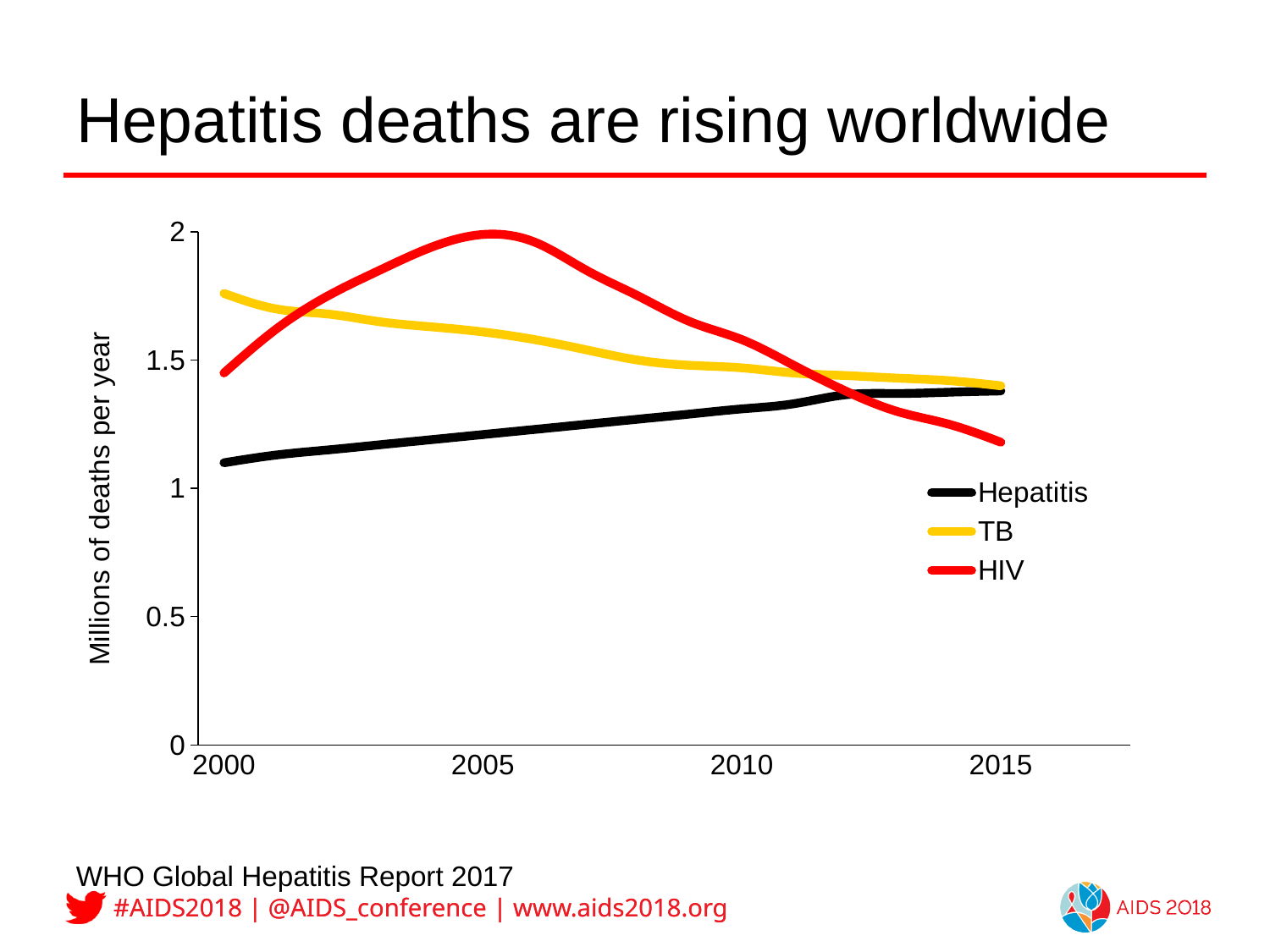
Is the value for Hepatitis in 2000 greater or less than 1.5? less What is the title of the chart on the slide? Hepatitis deaths are rising worldwide How many series does the legend list? 3 Which series are listed in the legend? Hepatitis, TB, HIV What kind of chart is shown on the slide? line chart Which series has the lowest value in 2000? Hepatitis Do TB deaths rise or fall from 2000 to 2015? fall Is the value for HIV in 2005 greater or less than 1.5? greater Which series reaches the highest value anywhere on the chart? HIV Do Hepatitis deaths rise or fall from 2000 to 2015? rise In 2015, which is larger, the value for TB or the value for HIV? TB Which series has the highest value in 2000? TB